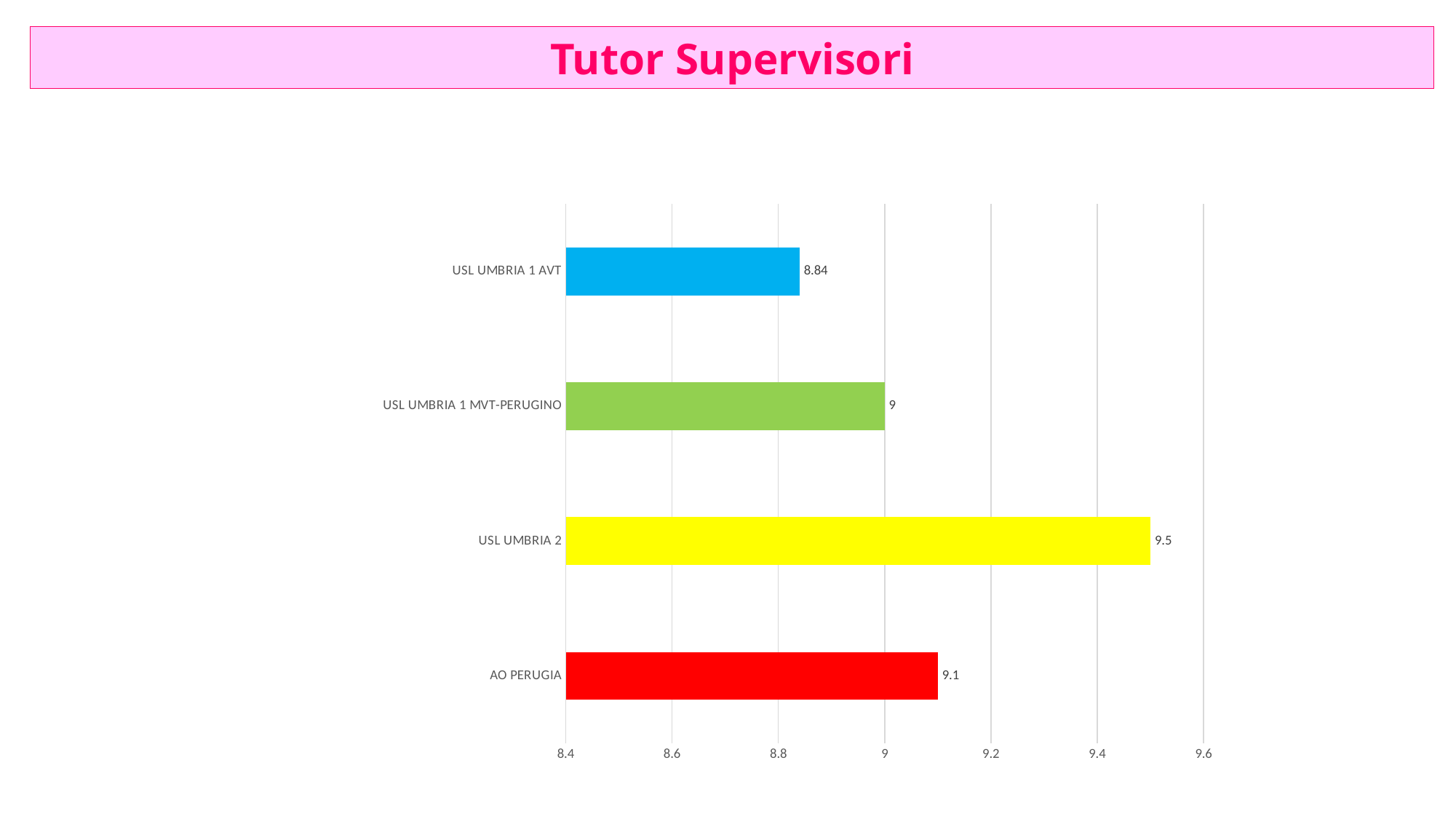
Which category has the lowest value? USL UMBRIA 1 AVT Which is larger, the value for AO PERUGIA or the value for USL UMBRIA 1 MVT-PERUGINO? AO PERUGIA How many categories are shown in the chart? 4 What kind of chart is shown on the slide? Bar chart What is the value for USL UMBRIA 1 AVT? 8.84 Which category has the highest value? USL UMBRIA 2 What is the value for USL UMBRIA 1 MVT-PERUGINO? 9 What is the value for USL UMBRIA 2? 9.5 Is the value for USL UMBRIA 2 greater or less than 9.4? greater What is the difference between the values for USL UMBRIA 1 MVT-PERUGINO and USL UMBRIA 1 AVT? 0.16 What is the value for AO PERUGIA? 9.1 What is the difference between the values for USL UMBRIA 2 and AO PERUGIA? 0.4